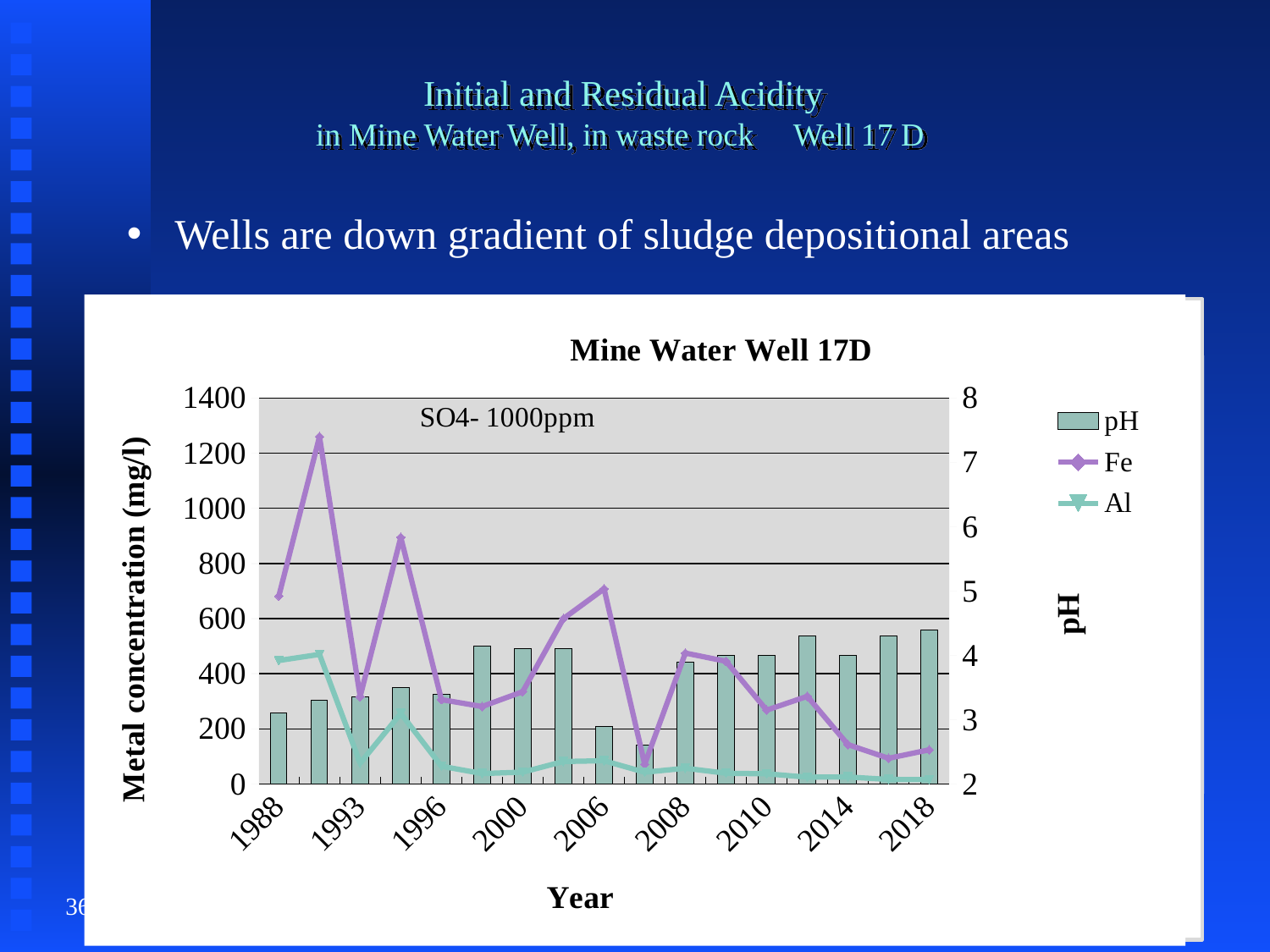
Is the Al value for 2018 greater or less than 200? less Is the pH value for 1988 greater or less than 4? less Is the Fe value for 1993 greater or less than 400? less Which labelled year has the lowest pH bar? 2006 Does the Fe line overall rise or fall from 1988 to 2018? fall What is the title of the chart? Mine Water Well 17D Which is larger, the Fe value for 1988 or the Fe value for 2018? 1988 How many series does the chart legend list? 3 Which series in the chart is plotted as bars rather than a line? pH